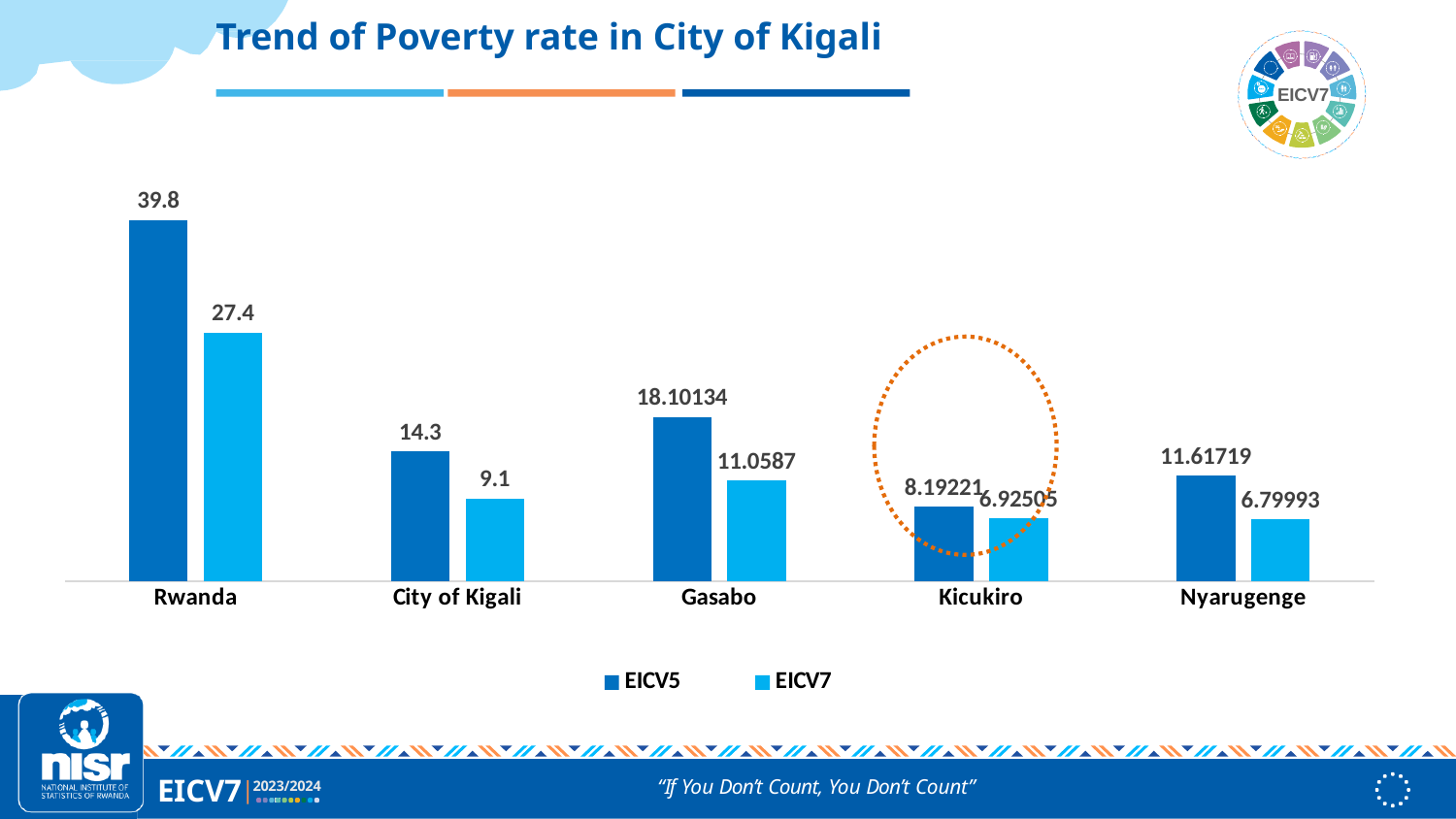
How many series does the legend list? 2 What is the difference between the EICV5 and EICV7 values for City of Kigali? 5.2 What is the difference between the EICV5 and EICV7 values for Rwanda? 12.4 What is the EICV7 value for Nyarugenge? 6.79993 What kind of chart is shown on the slide? Bar chart Which category has the lowest EICV7 value? Nyarugenge What is the EICV7 poverty rate for City of Kigali? 9.1 What is the EICV5 poverty rate for Rwanda? 39.8 Which category has the highest EICV5 value? Rwanda How many categories are shown on the x axis? 5 What is the EICV5 value for Gasabo? 18.10134 Which is larger, the EICV5 value for Gasabo or the EICV5 value for Nyarugenge? Gasabo